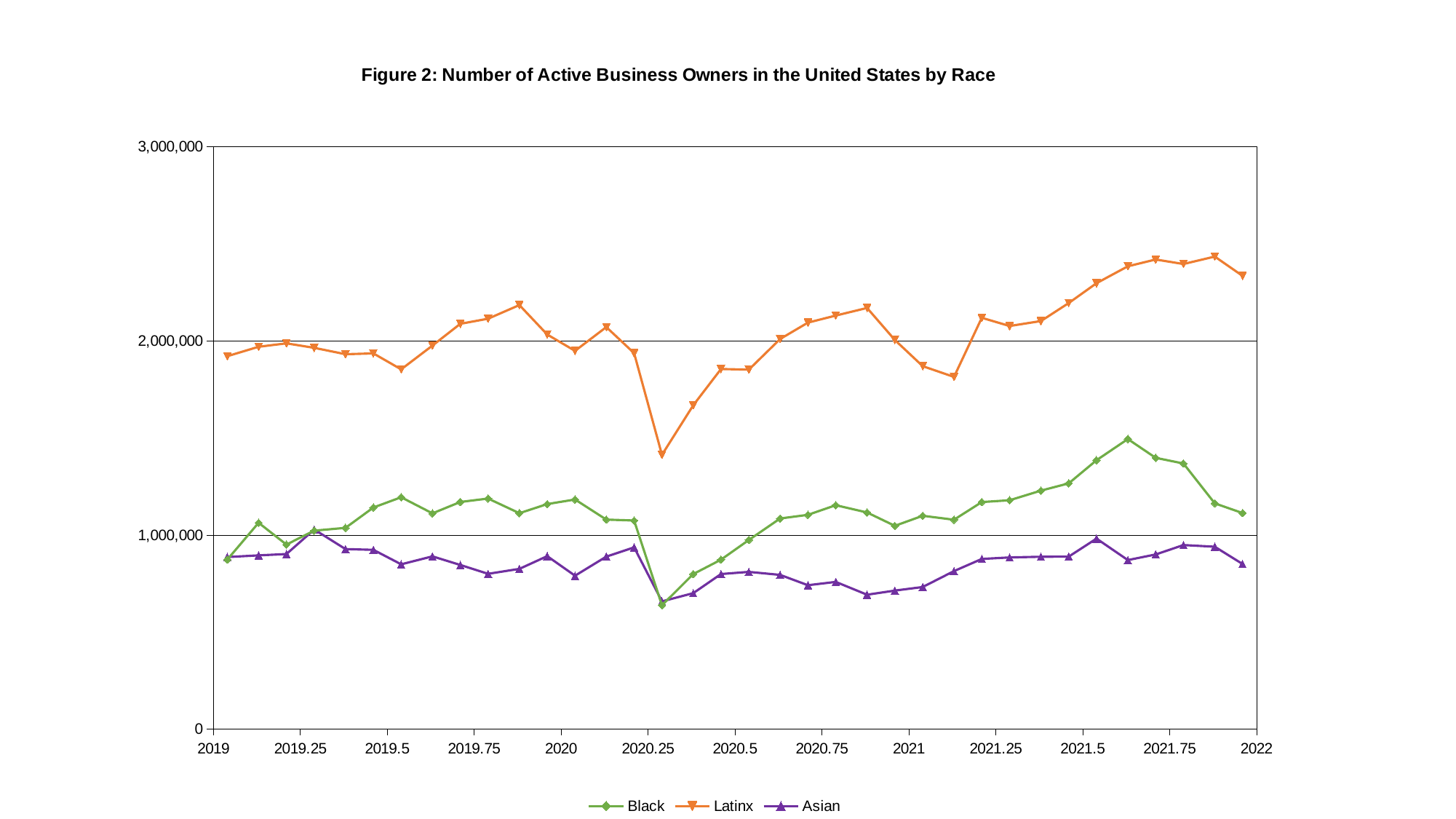
Is the value for Asian at 2020.25 greater or less than 1,000,000? less How many series does the legend list? 3 Is the value for Black at its peak near 2021.5 greater or less than 1,000,000? greater Is the value for Latinx at its lowest point near 2020.25 greater or less than 2,000,000? less Does the Latinx series rise or fall between 2020.25 and 2021.75? rise What kind of chart is shown on the slide? line chart At 2021, which series has the larger value, Black or Asian? Black Which series has the highest values throughout the chart? Latinx Which series has the lowest values for most of the chart? Asian What is the title of the chart? Figure 2: Number of Active Business Owners in the United States by Race Which series is plotted in orange? Latinx